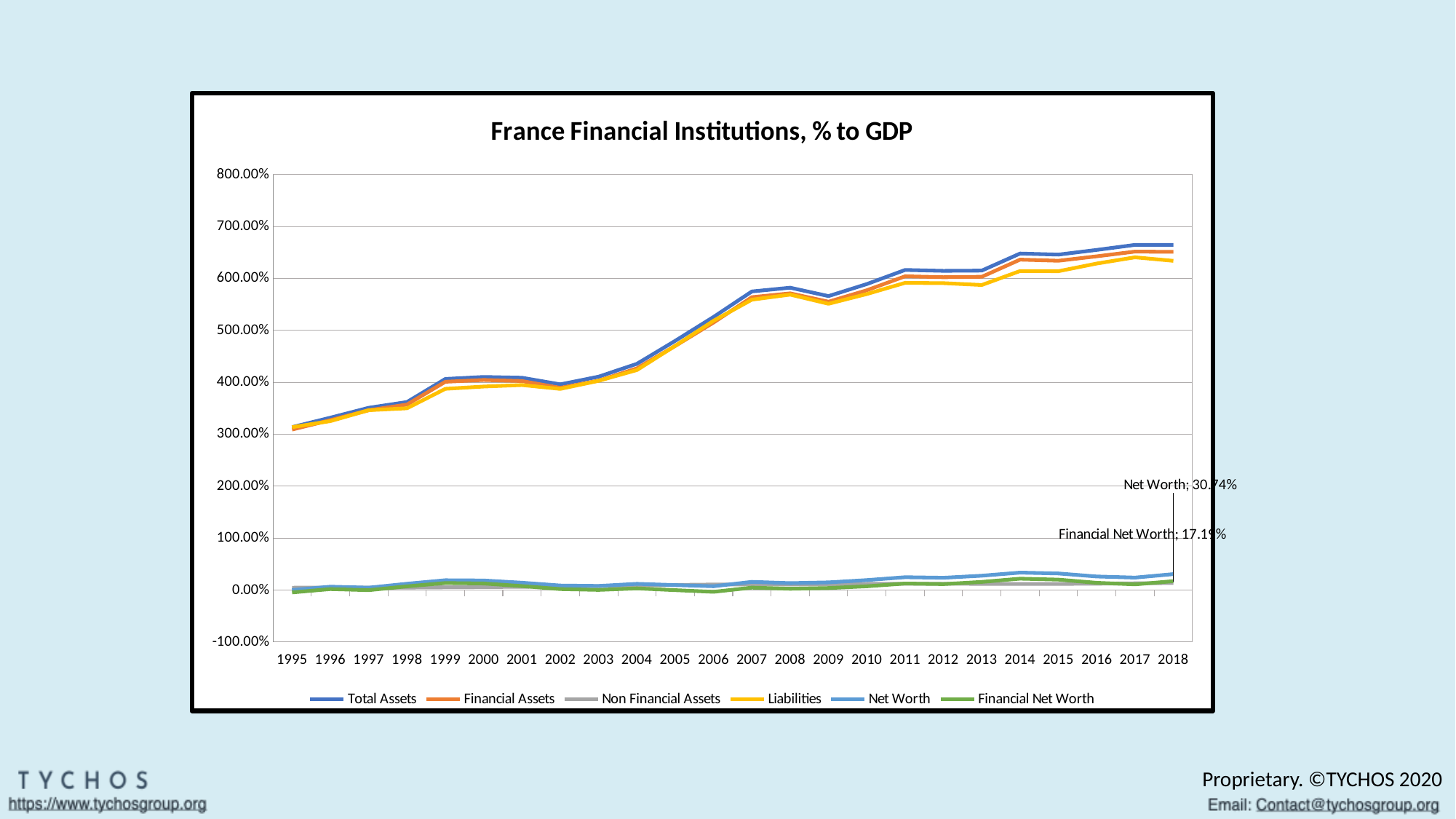
Does Total Assets generally rise or fall from 1995 to 2018? rise What is the Net Worth value labelled for 2018? 30.74% What kind of chart is shown on the slide? line chart Is the value for Total Assets in 1995 greater or less than 400.00%? less Is the value for Total Assets in 2018 greater or less than 600.00%? greater Is the value for Liabilities in 2007 greater or less than 500.00%? greater What is the title of the chart? France Financial Institutions, % to GDP In 2018, which is larger: Net Worth or Financial Net Worth? Net Worth How many series does the legend list? 6 How many years are shown on the x axis? 24 What is the difference between the labelled Net Worth and Financial Net Worth values for 2018? 13.55% What is the Financial Net Worth value labelled for 2018? 17.19%